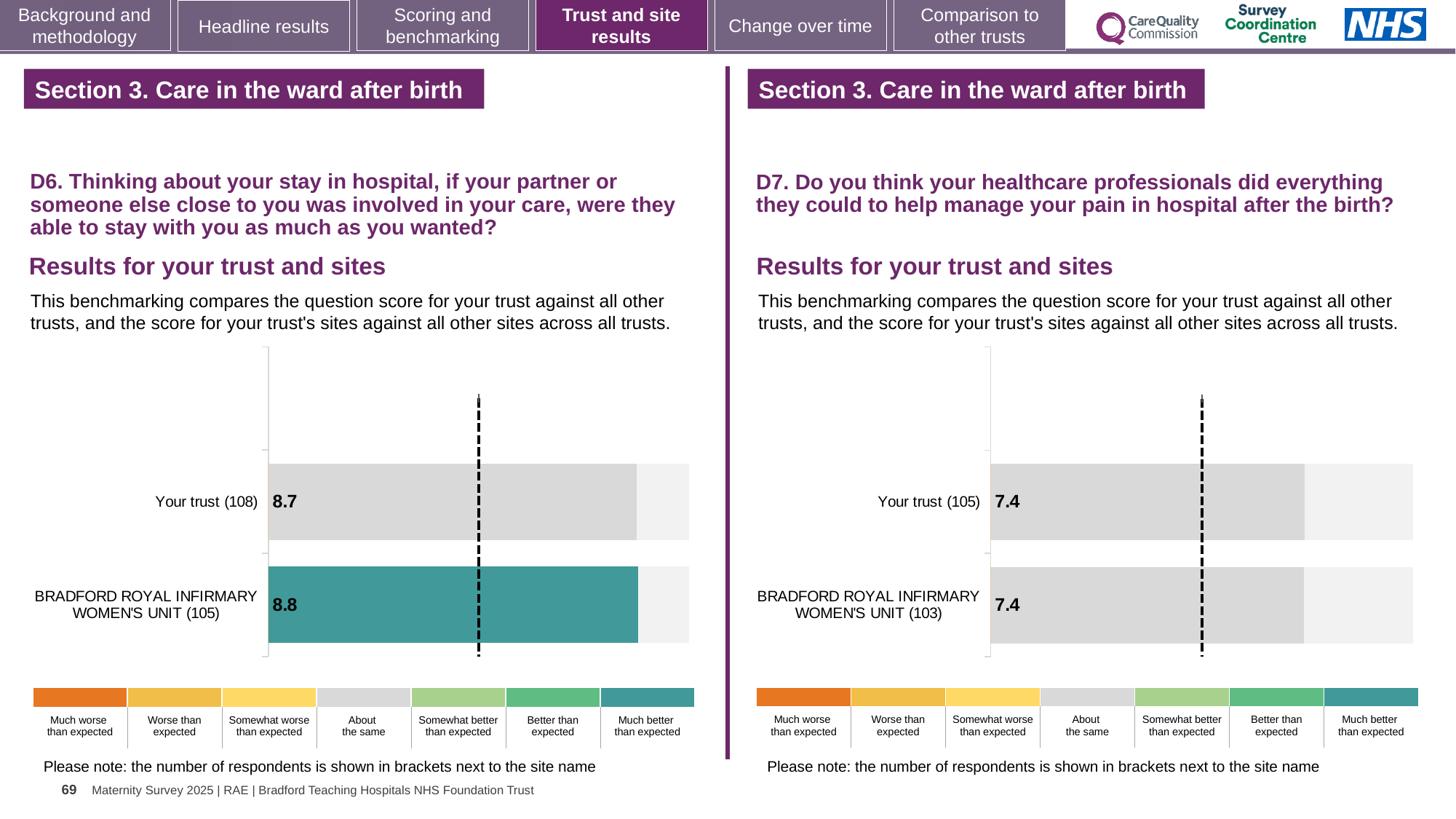
How many bars are shown on the left chart (D6)? 2 On the left chart (D6), which benchmark category does the teal colour of the Bradford Royal Infirmary Women's Unit bar correspond to in the legend? Much better than expected On the left chart (D6), what is the score for Bradford Royal Infirmary Women's Unit? 8.8 What type of chart is used on the right (D7)? Bar chart On the left chart (D6), how many respondents are shown in brackets for Your trust? 108 On the right chart (D7), what is the difference between the Your trust score and the Bradford Royal Infirmary Women's Unit score? 0 On the right chart (D7), what is the score for Bradford Royal Infirmary Women's Unit? 7.4 On the left chart (D6), what is the score for Your trust? 8.7 On the right chart (D7), how many respondents are shown in brackets for Bradford Royal Infirmary Women's Unit? 103 On the left chart (D6), which has the higher score, Your trust or Bradford Royal Infirmary Women's Unit? Bradford Royal Infirmary Women's Unit On the left chart (D6), what is the difference between the Bradford Royal Infirmary Women's Unit score and the Your trust score? 0.1 On the right chart (D7), what is the score for Your trust? 7.4